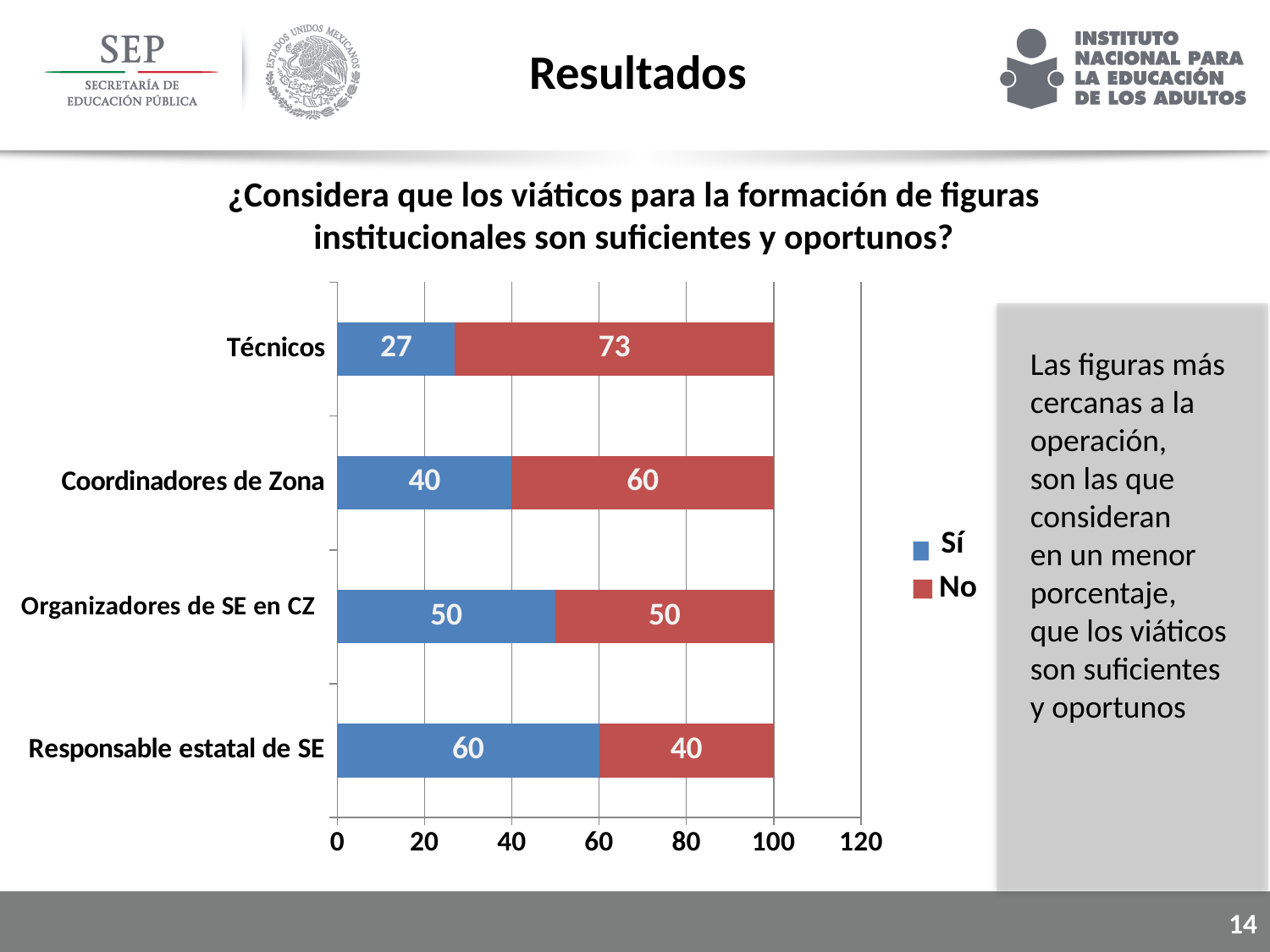
What is the difference between the 'No' and 'Sí' values for Técnicos? 46 How many series does the legend list? 2 Which is larger for Coordinadores de Zona, the 'Sí' value or the 'No' value? No What is the total of the stacked bar for Organizadores de SE en CZ? 100 Which category has the lowest 'Sí' value? Técnicos What is the 'No' value for Coordinadores de Zona? 60 What kind of chart is shown on the slide? Stacked bar chart How many categories are shown on the chart? 4 Which colour represents the 'No' series in the chart? Red What is the 'Sí' value for Técnicos? 27 What is the 'Sí' value for Responsable estatal de SE? 60 Which category has the highest 'No' value? Técnicos